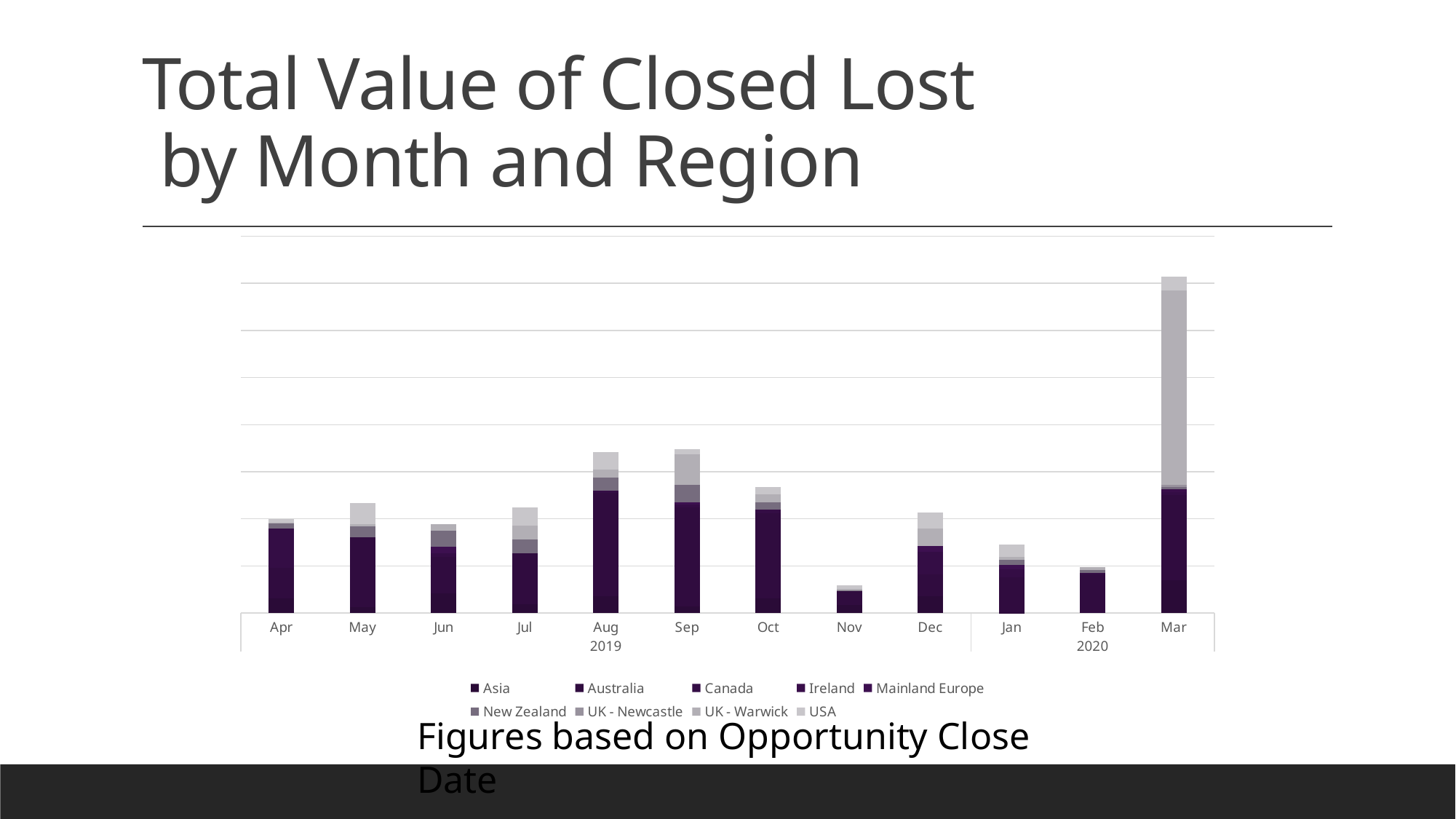
Which month has the larger total bar, Dec 2019 or Nov 2019? Dec 2019 Which month has the larger total bar, Mar 2020 or Sep 2019? Mar 2020 What kind of chart is shown on the slide? Stacked bar chart How many months are plotted along the x axis of the chart? 12 How many regions does the chart's legend list? 9 Which month has the larger total bar, Apr 2019 or Feb 2020? Apr 2019 Which month has the highest total value of closed lost? Mar 2020 Which region makes up the largest part of the Mar 2020 bar? UK - Warwick Which month has the lowest total value of closed lost? Nov 2019 What is the title of the slide containing the chart? Total Value of Closed Lost by Month and Region